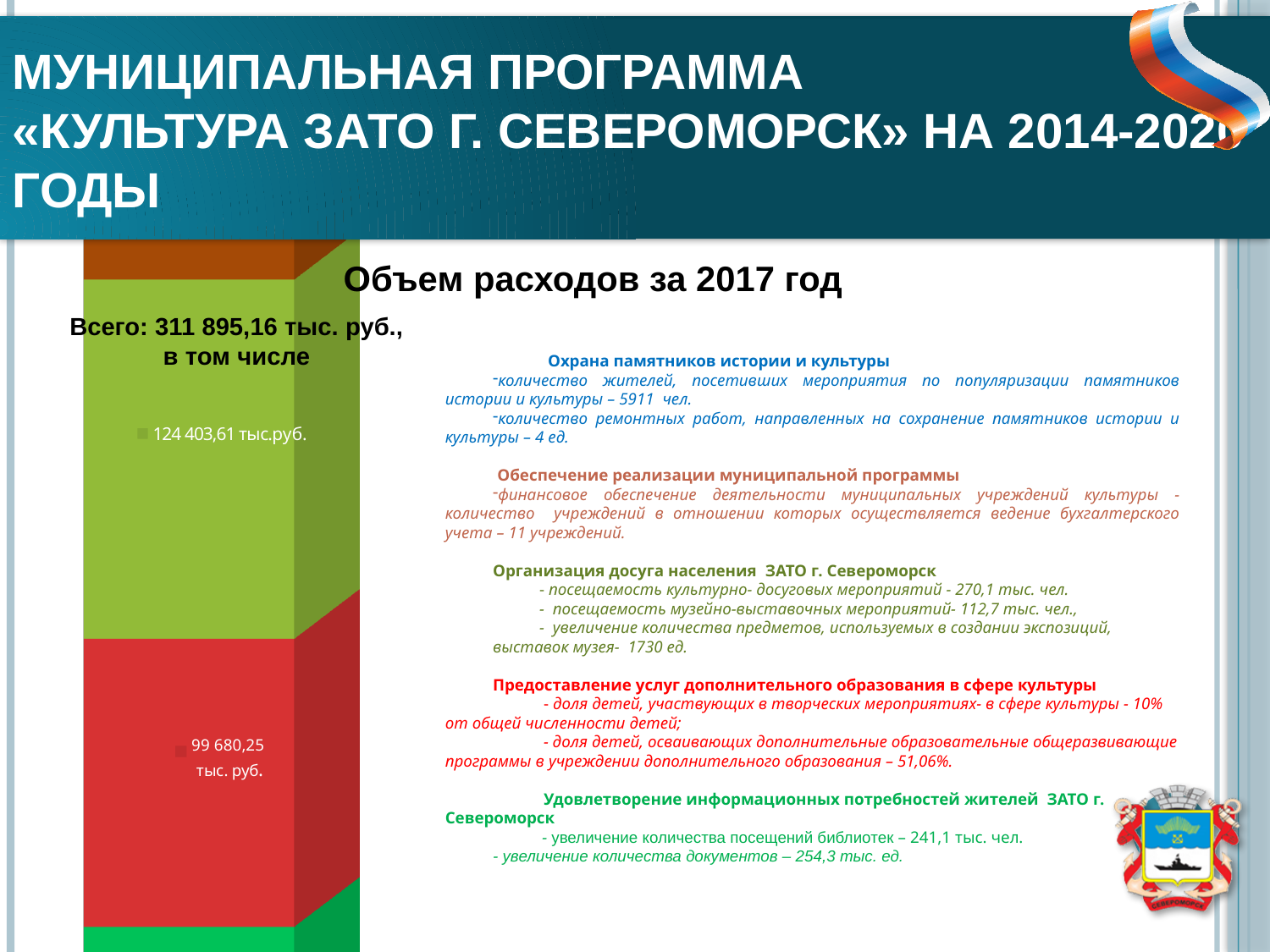
What value is printed on the red segment of the stacked bar? 99 680,25 тыс. руб. What colour is the segment labelled 99 680,25 тыс. руб.? red What is the difference between the light green segment (124 403,61) and the red segment (99 680,25) of the stacked bar? 24 723,36 тыс. руб. Which segment of the stacked bar is larger, the light green one or the red one? the light green one What value is printed on the light green segment of the stacked bar? 124 403,61 тыс.руб. What colour is the segment labelled 124 403,61 тыс.руб.? light green What kind of chart is shown on the left of the slide? a stacked bar chart